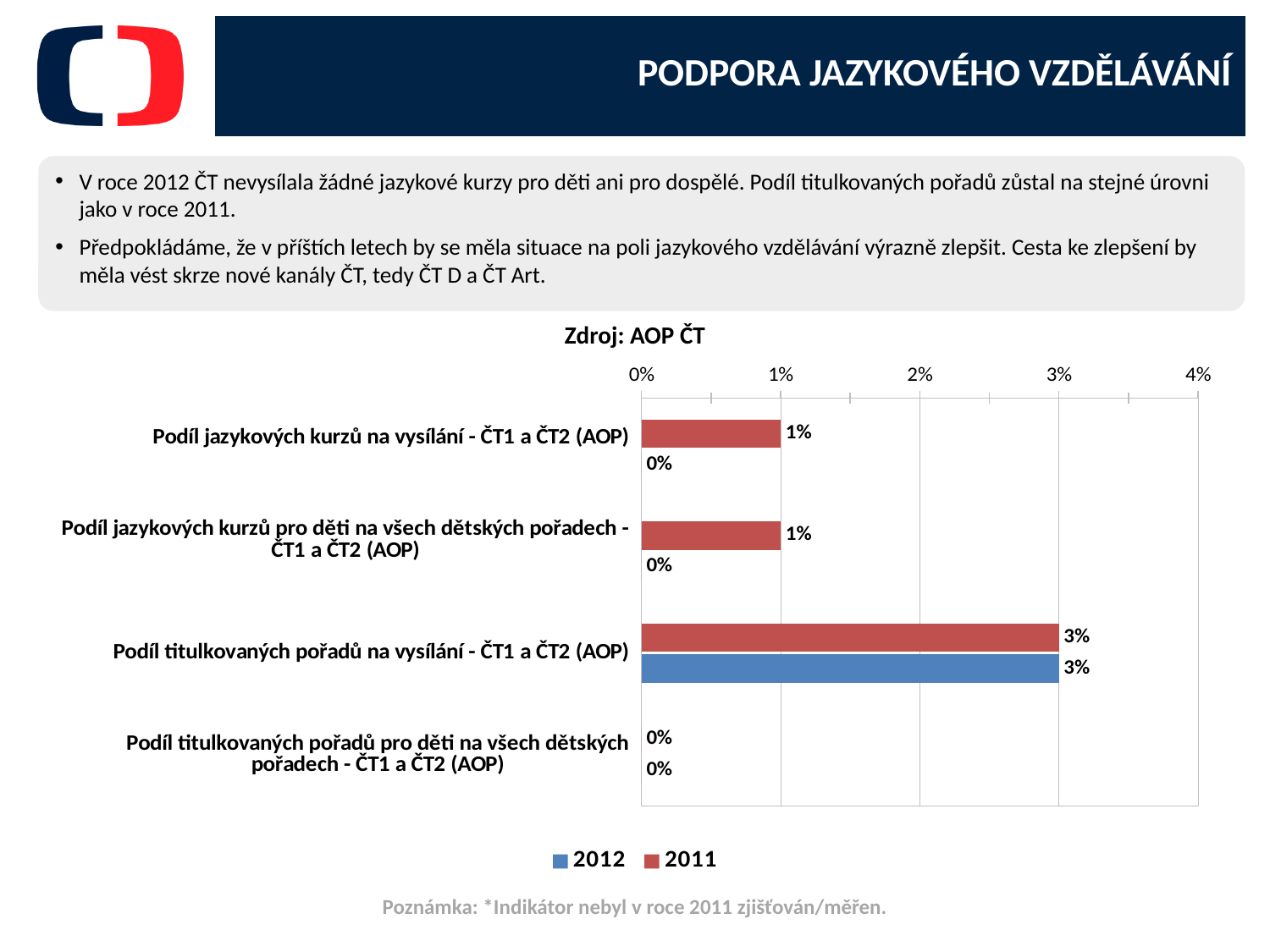
What is the 2012 value for "Podíl jazykových kurzů na vysílání - ČT1 a ČT2 (AOP)"? 0% How many categories are shown on the chart? 4 Is the 2011 value for "Podíl titulkovaných pořadů na vysílání - ČT1 a ČT2 (AOP)" greater or less than 2%? greater Which category has the highest 2011 value? Podíl titulkovaných pořadů na vysílání - ČT1 a ČT2 (AOP) What is the 2011 value for "Podíl jazykových kurzů na vysílání - ČT1 a ČT2 (AOP)"? 1% What is the difference between the 2011 and 2012 values for "Podíl jazykových kurzů pro děti na všech dětských pořadech - ČT1 a ČT2 (AOP)"? 1% What type of chart is shown on the slide? bar chart Which series is shown in blue in the legend? 2012 What is the title shown above the chart? Zdroj: AOP ČT What is the 2012 value for "Podíl titulkovaných pořadů pro děti na všech dětských pořadech - ČT1 a ČT2 (AOP)"? 0% How many series does the chart legend list? 2 What is the 2011 value for "Podíl titulkovaných pořadů na vysílání - ČT1 a ČT2 (AOP)"? 3%